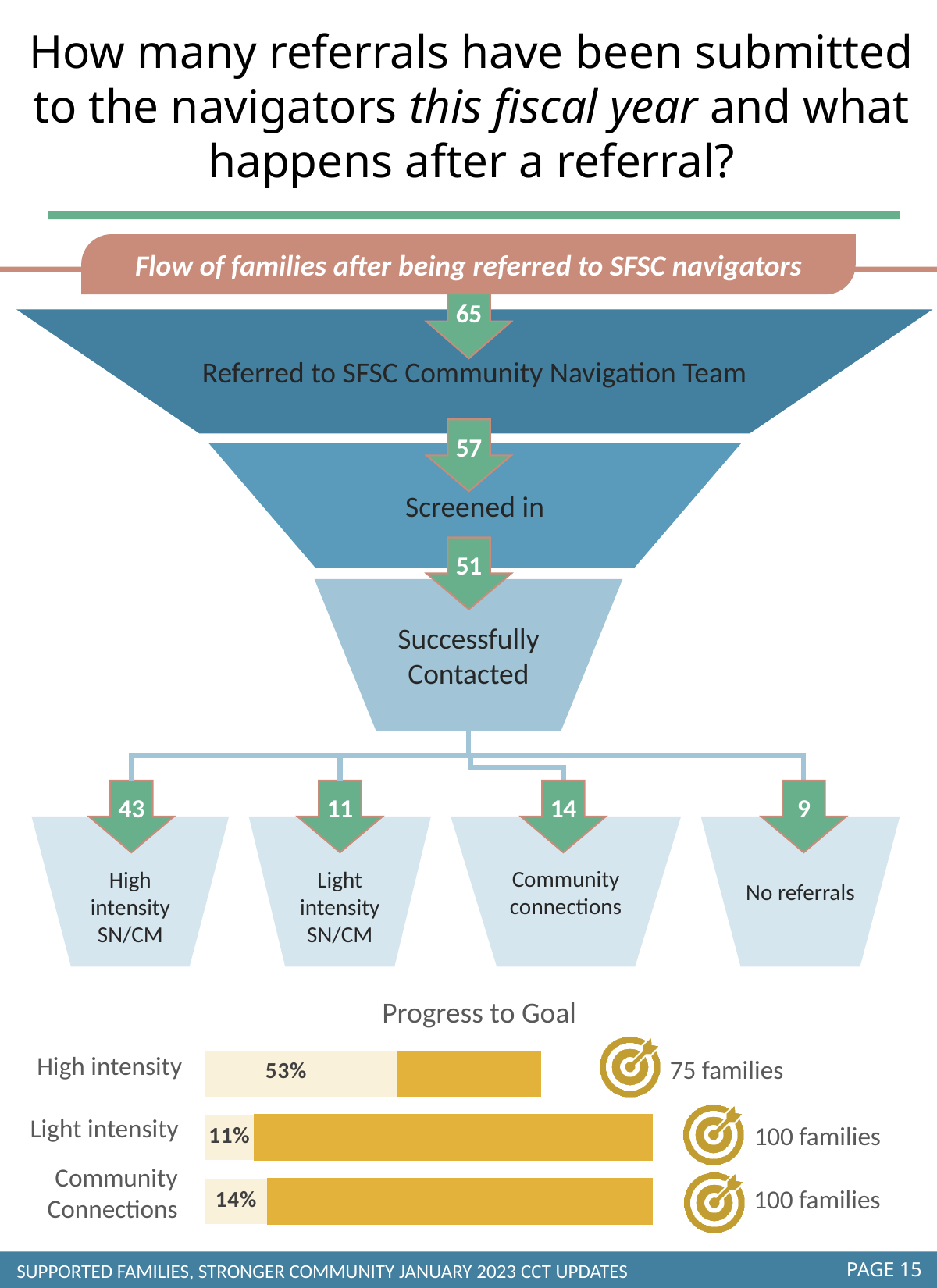
In the funnel diagram, what is the difference between the number screened in and the number successfully contacted? 6 In the funnel diagram, how many families were referred to the SFSC Community Navigation Team? 65 In the 'Progress to Goal' chart, how many categories are shown? 3 In the 'Progress to Goal' chart, what percentage is shown for Light intensity? 11% In the 'Progress to Goal' chart, what is the goal number of families for High intensity? 75 families In the funnel diagram, which outcome after successful contact has the largest number of families? High intensity SN/CM In the 'Progress to Goal' chart, what percentage is shown for High intensity? 53% In the 'Progress to Goal' chart, which category has the highest progress percentage? High intensity What kind of chart is the 'Progress to Goal' chart? Bar chart In the funnel diagram, how many families were successfully contacted? 51 In the 'Progress to Goal' chart, what percentage is shown for Community Connections? 14% In the 'Progress to Goal' chart, which category has the lowest progress percentage? Light intensity